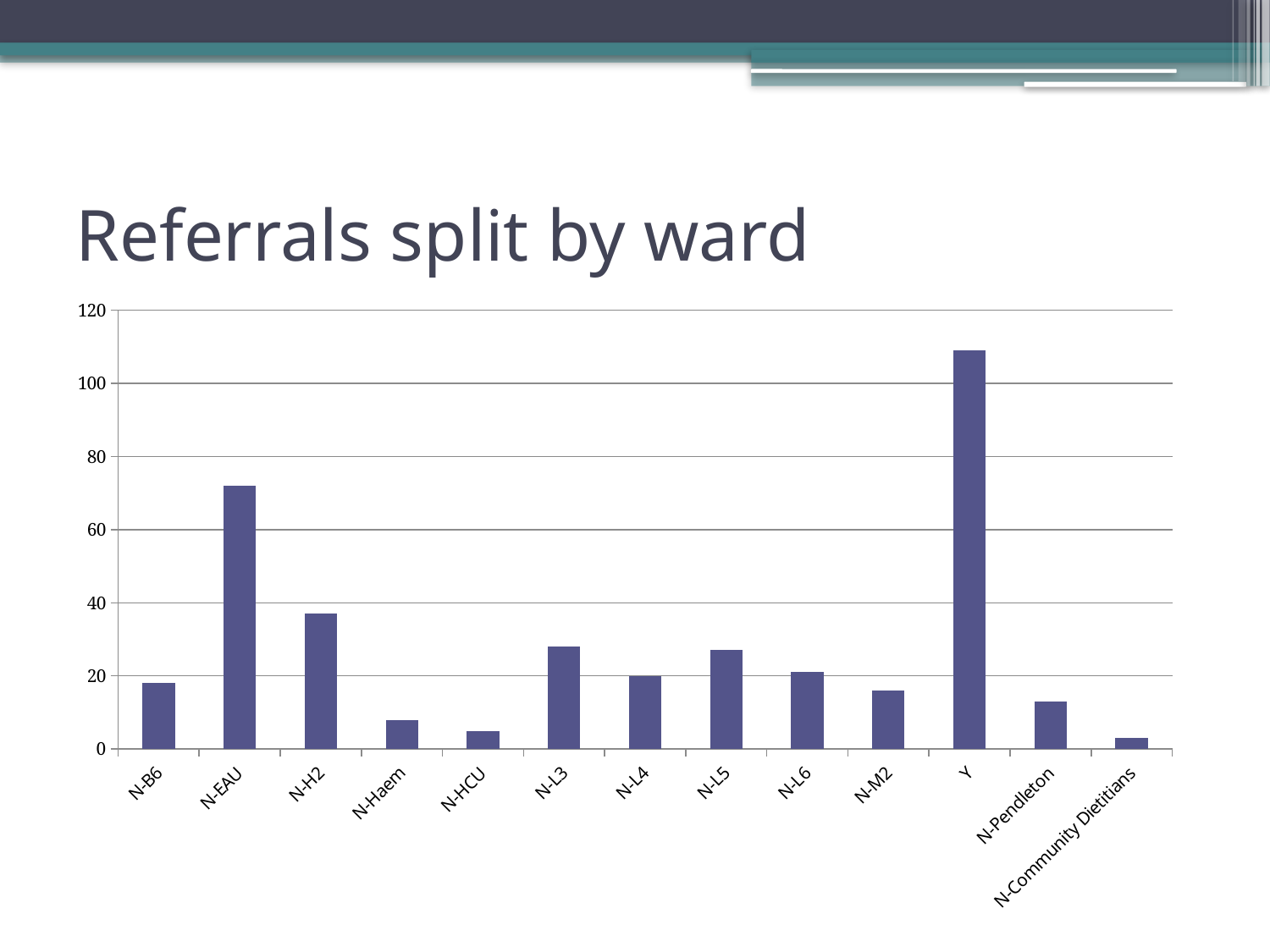
Is the value for N-Haem greater or less than 20? less Is the value for N-L3 greater or less than 20? greater Is the value for N-H2 greater or less than 40? less How many wards (categories) are shown on the x axis? 13 Which ward has the highest number of referrals? Y Which has more referrals, N-EAU or N-H2? N-EAU What type of chart is shown on the slide? bar chart What is the title of the chart? Referrals split by ward Which has more referrals, N-L6 or N-Pendleton? N-L6 Which ward has the lowest number of referrals? N-Community Dietitians